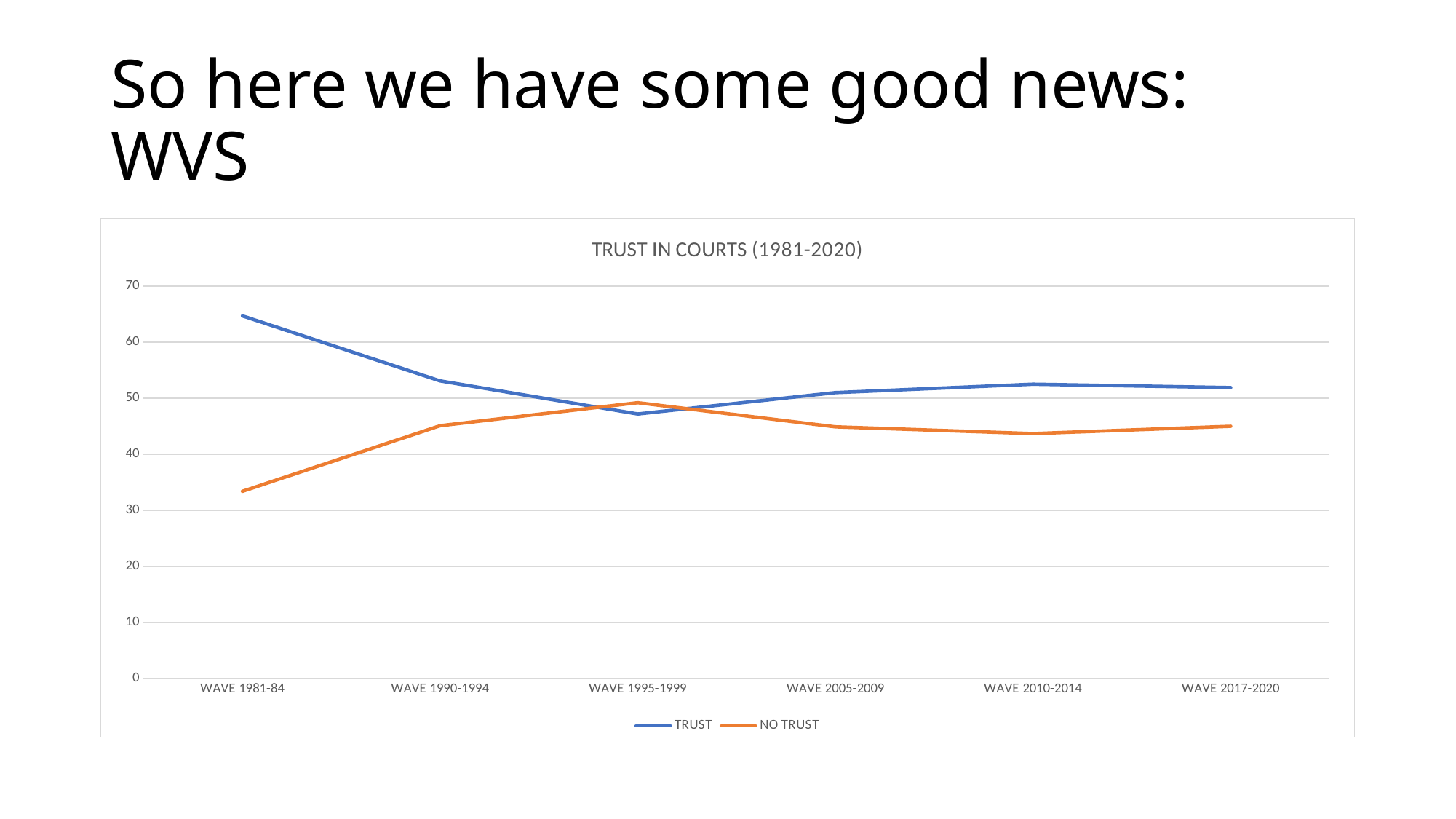
Is the value for TRUST in WAVE 1981-84 greater or less than 60? greater How many series does the legend list? 2 What is the title of the chart? TRUST IN COURTS (1981-2020) What kind of chart is shown on the slide? line chart Which series is drawn in orange? NO TRUST In which wave is the NO TRUST series at its lowest? WAVE 1981-84 In which wave is the TRUST series at its highest? WAVE 1981-84 Is the value for NO TRUST in WAVE 1981-84 greater or less than 40? less In WAVE 2017-2020, which series has the larger value, TRUST or NO TRUST? TRUST How many waves are plotted along the x axis? 6 Does the TRUST series rise or fall between WAVE 1981-84 and WAVE 1995-1999? fall In which wave is the TRUST series at its lowest? WAVE 1995-1999